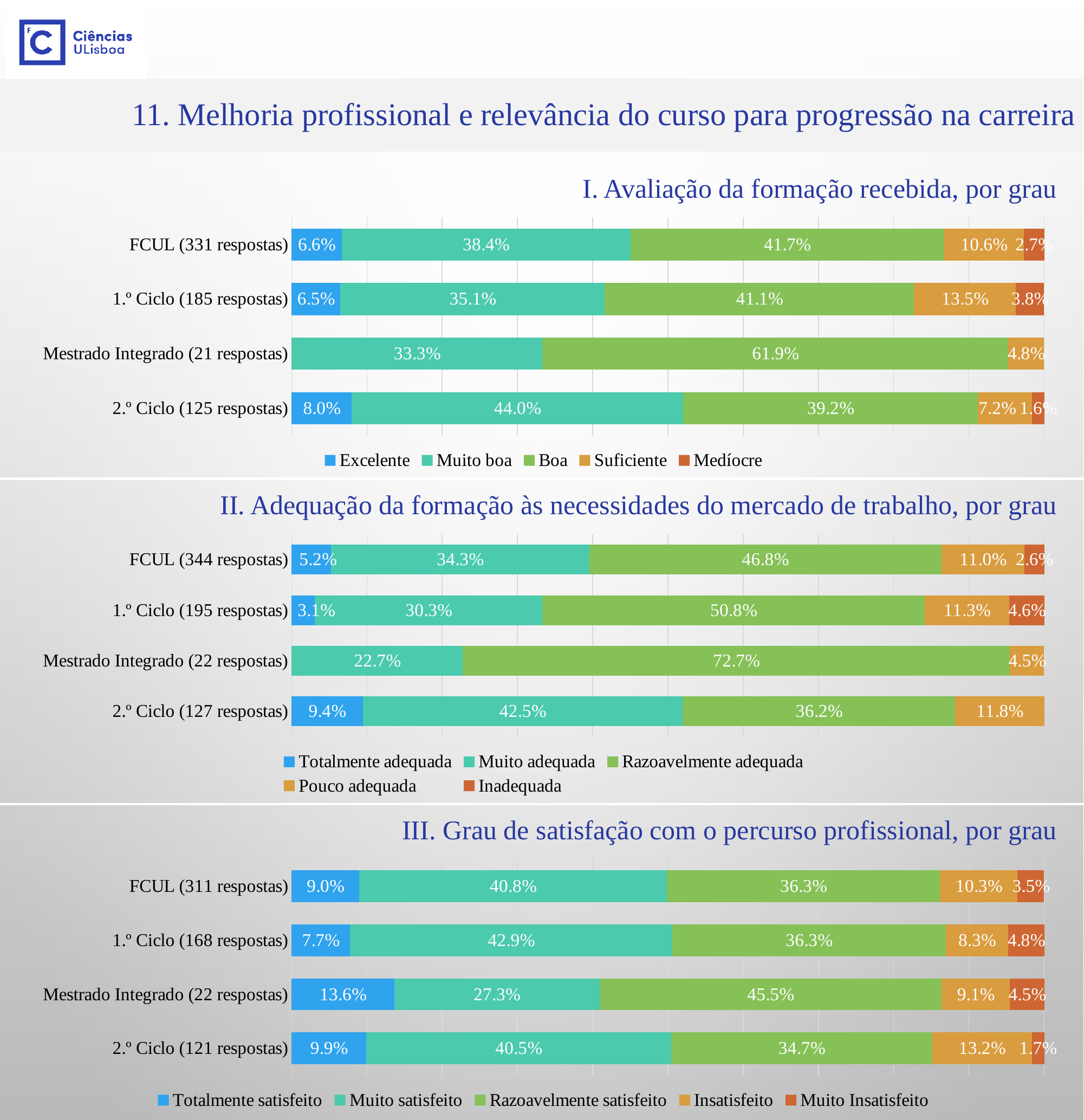
In chart I (Avaliação da formação recebida, por grau), what is the 'Muito boa' value for 2.º Ciclo (125 respostas)? 44.0% In chart I (Avaliação da formação recebida, por grau), what is the difference between the 'Boa' values for FCUL (331 respostas) and 1.º Ciclo (185 respostas)? 0.6% What type of chart is chart I (Avaliação da formação recebida, por grau)? Stacked bar chart In chart III (Grau de satisfação com o percurso profissional, por grau), what is the 'Totalmente satisfeito' value for Mestrado Integrado (22 respostas)? 13.6% In chart II (Adequação da formação às necessidades do mercado de trabalho, por grau), which category has the lowest 'Totalmente adequada' value among those with a printed label? 1.º Ciclo (195 respostas) In chart II (Adequação da formação às necessidades do mercado de trabalho, por grau), what is the 'Razoavelmente adequada' value for Mestrado Integrado (22 respostas)? 72.7% In chart I (Avaliação da formação recebida, por grau), what is the 'Boa' value for Mestrado Integrado (21 respostas)? 61.9% In chart I (Avaliação da formação recebida, por grau), which category has the highest 'Suficiente' value? 1.º Ciclo (185 respostas) In chart III (Grau de satisfação com o percurso profissional, por grau), which is larger: the 'Insatisfeito' value for 2.º Ciclo (121 respostas) or for 1.º Ciclo (168 respostas)? 2.º Ciclo (121 respostas) In chart III (Grau de satisfação com o percurso profissional, por grau), what is the difference between the 'Muito satisfeito' values for 1.º Ciclo (168 respostas) and Mestrado Integrado (22 respostas)? 15.6% How many categories (bars) are shown in chart III (Grau de satisfação com o percurso profissional, por grau)? 4 In chart II (Adequação da formação às necessidades do mercado de trabalho, por grau), how many series does the legend list? 5